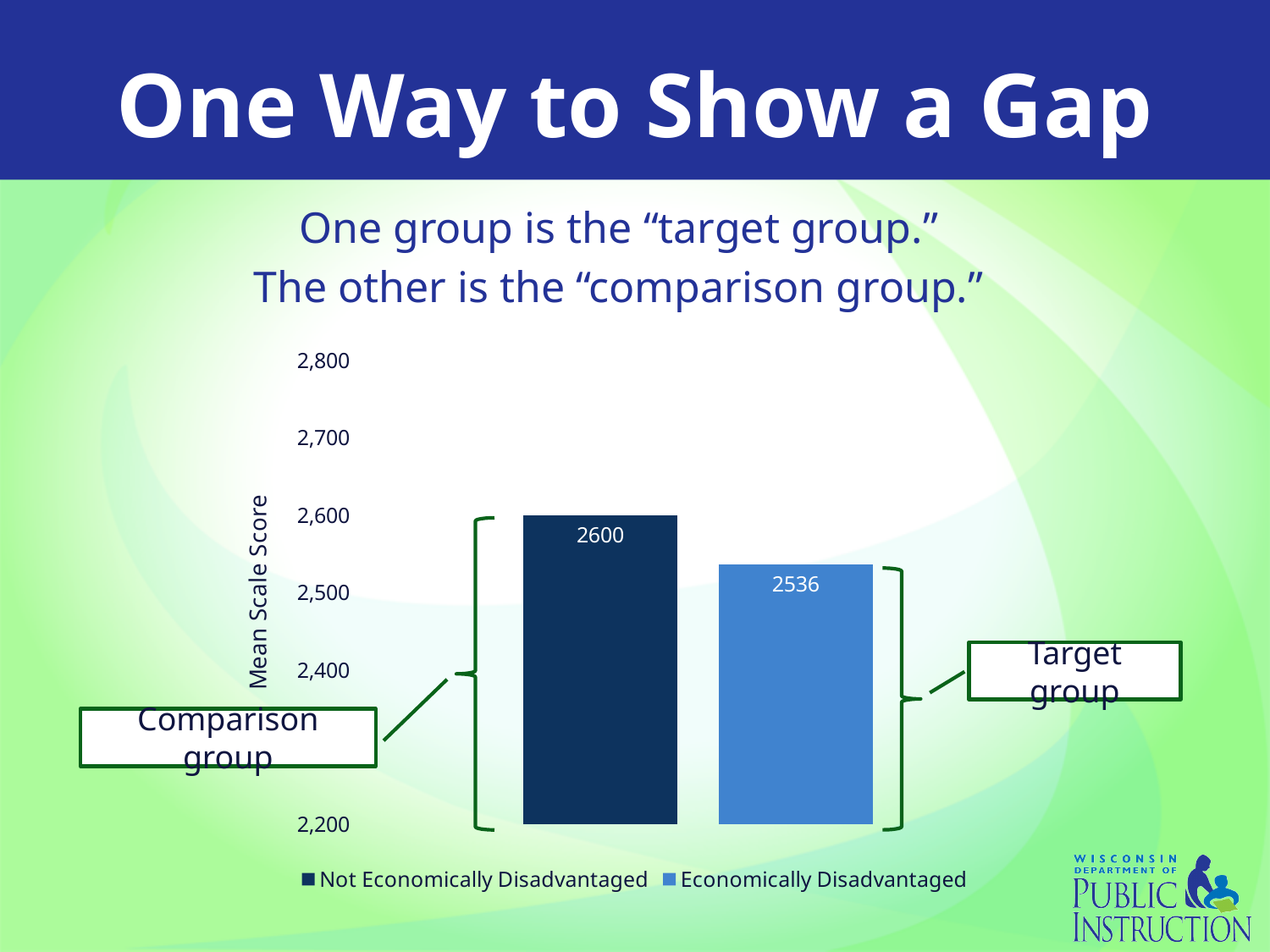
What is the Mean Scale Score for Economically Disadvantaged? 2536 Which group has the higher Mean Scale Score? Not Economically Disadvantaged What is the label on the vertical axis? Mean Scale Score Is the value for Not Economically Disadvantaged greater or less than 2,700? less What is the difference between the Not Economically Disadvantaged and Economically Disadvantaged scores? 64 What kind of chart is shown on the slide? Bar chart Is the value for Economically Disadvantaged greater or less than 2,500? greater How many bars are plotted in the chart? 2 What is the Mean Scale Score for Not Economically Disadvantaged? 2600 Which group is labelled as the target group? Economically Disadvantaged How many series does the legend list? 2 Which group has the lower Mean Scale Score? Economically Disadvantaged